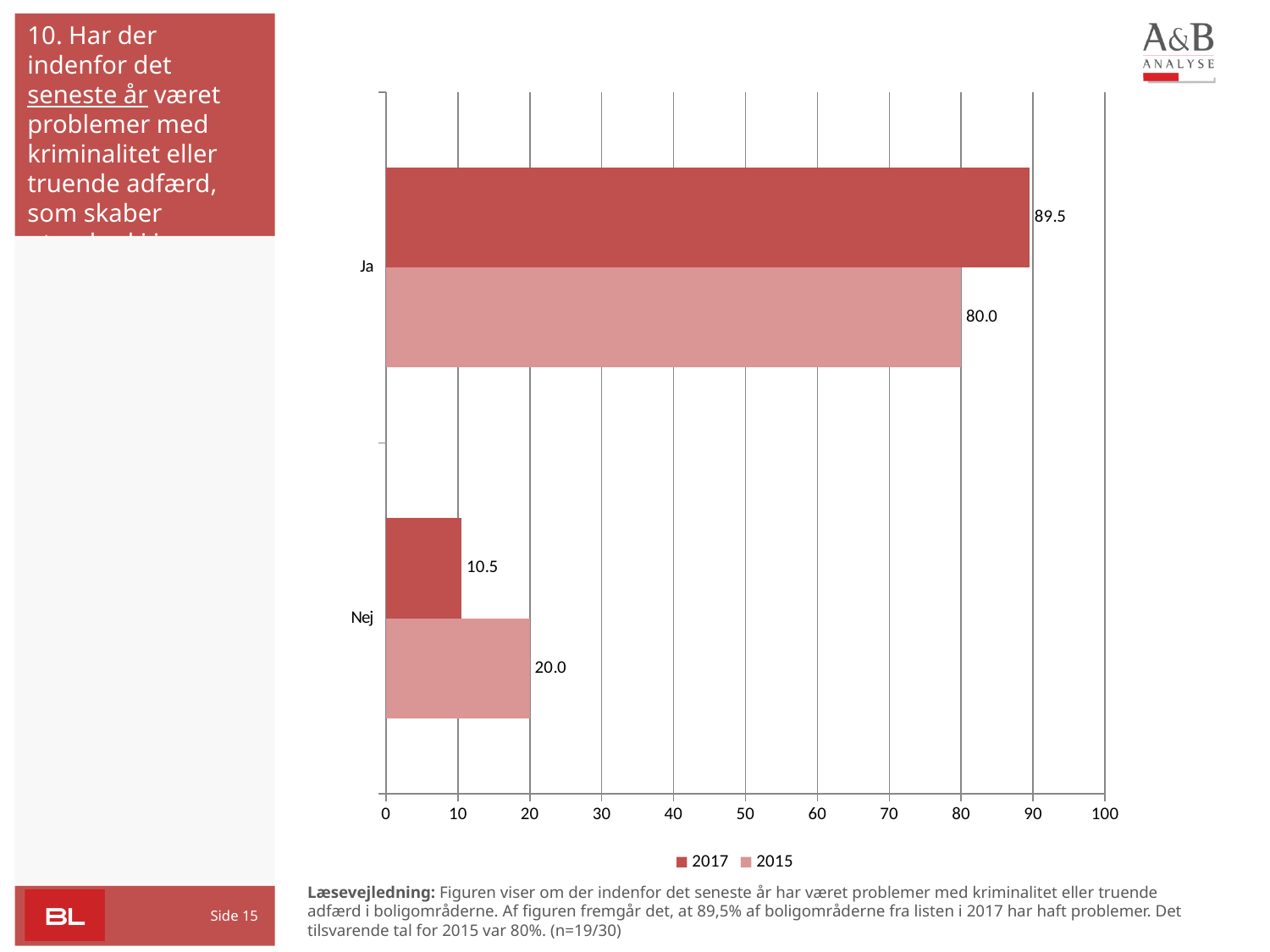
How many series does the legend list? 2 What is the value for "Nej" in the 2015 series? 20.0 Which category has the lowest value in the 2015 series? Nej What is the value for "Nej" in the 2017 series? 10.5 What is the value for "Ja" in the 2017 series? 89.5 Is the 2017 value for "Ja" greater or less than 80? greater Which category has the highest value in the 2017 series? Ja What is the difference between the 2017 and 2015 values for "Ja"? 9.5 What kind of chart is shown on the slide? Bar chart What is the value for "Ja" in the 2015 series? 80.0 How many categories are shown on the chart? 2 Which is larger for "Nej": the 2017 value or the 2015 value? 2015